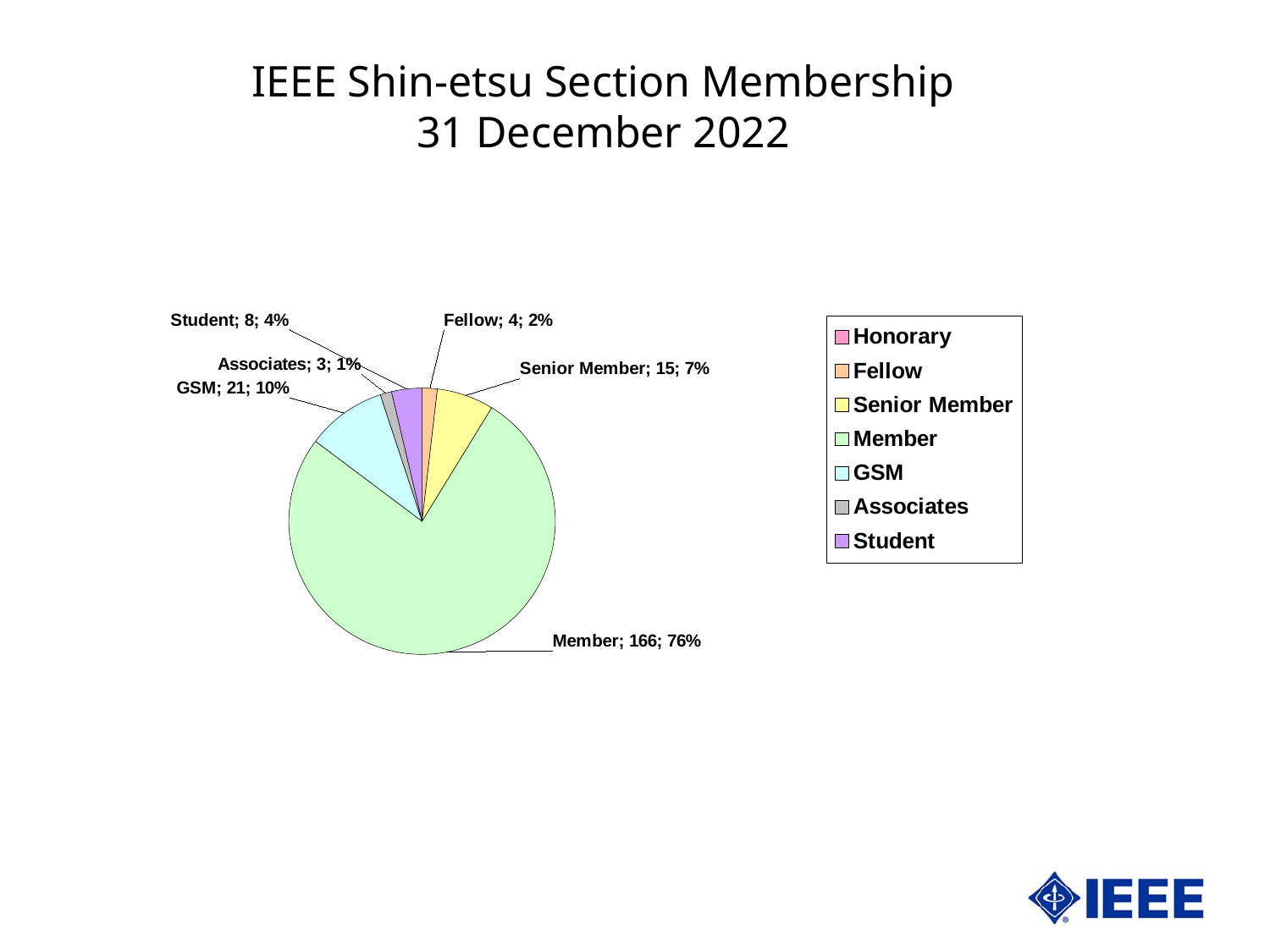
What share of the pie does the Student slice represent? 4% Which category has the largest slice of the pie? Member What is the combined count of Fellow and Senior Member? 19 What kind of chart is shown on the slide? pie chart Which labelled slice has the smallest count? Associates What is the difference between the Member count and the GSM count? 145 What percentage of the membership is Senior Member? 7% Which is larger, the Fellow count or the Student count? Student How many members are in the Member category? 166 How many entries does the legend list? 7 What is the title of the slide? IEEE Shin-etsu Section Membership 31 December 2022 How many members are in the GSM category? 21